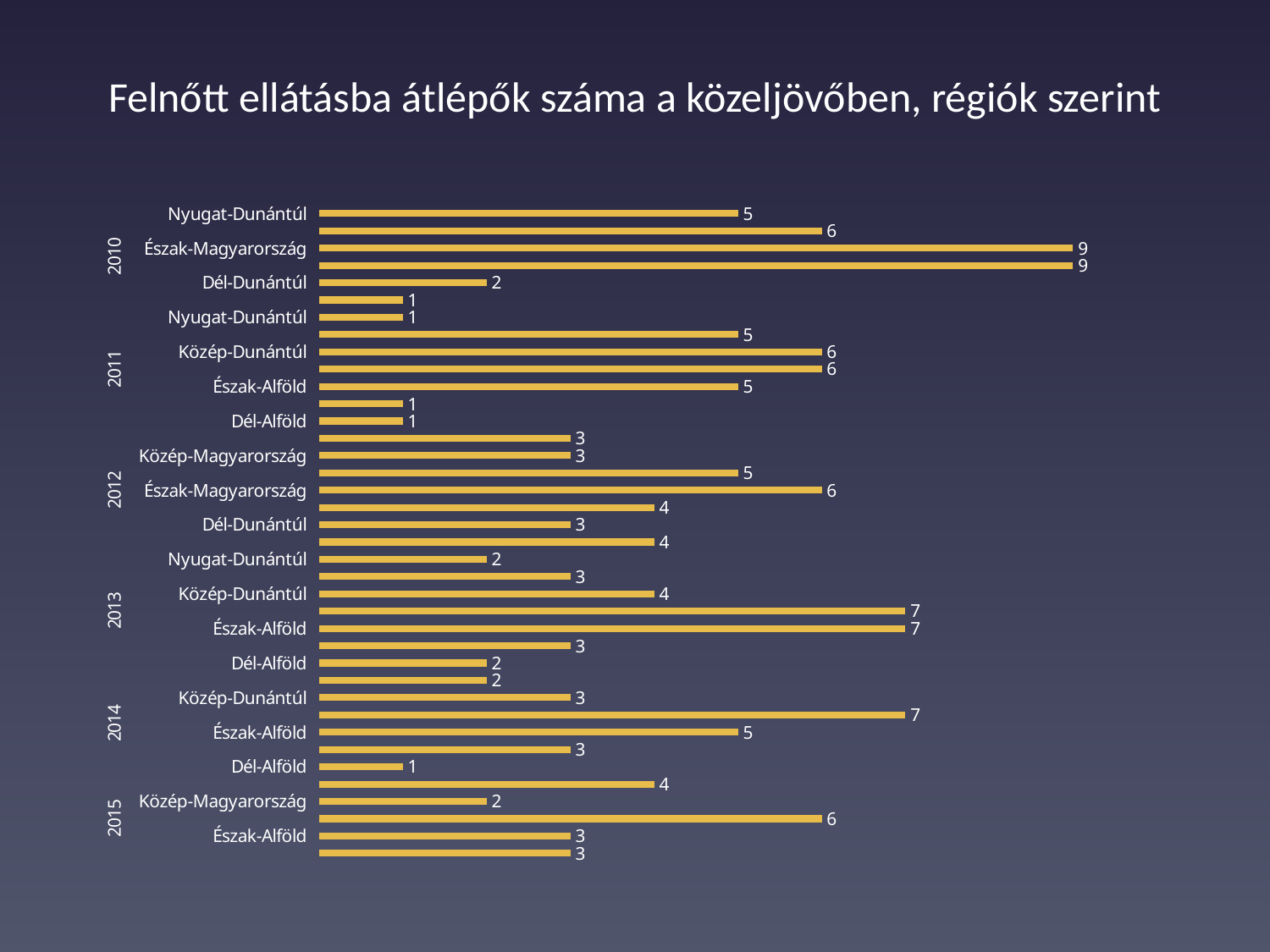
What is the value for Közép-Dunántúl in 2011? 6 What is the value for Észak-Magyarország in 2010? 9 Which is larger: the value for Nyugat-Dunántúl in 2010 or Nyugat-Dunántúl in 2011? Nyugat-Dunántúl in 2010 What is the value for Észak-Alföld in 2013? 7 What kind of chart is shown on the slide? bar chart How many years are shown on the chart's axis? 6 What is the value for Dél-Dunántúl in 2010? 2 What is the difference between the value for Észak-Alföld in 2013 and Észak-Alföld in 2014? 2 What is the value for Dél-Alföld in 2014? 1 What is the title of the chart? Felnőtt ellátásba átlépők száma a közeljövőben, régiók szerint What is the value for Közép-Magyarország in 2015? 2 What is the highest value shown on the chart? 9